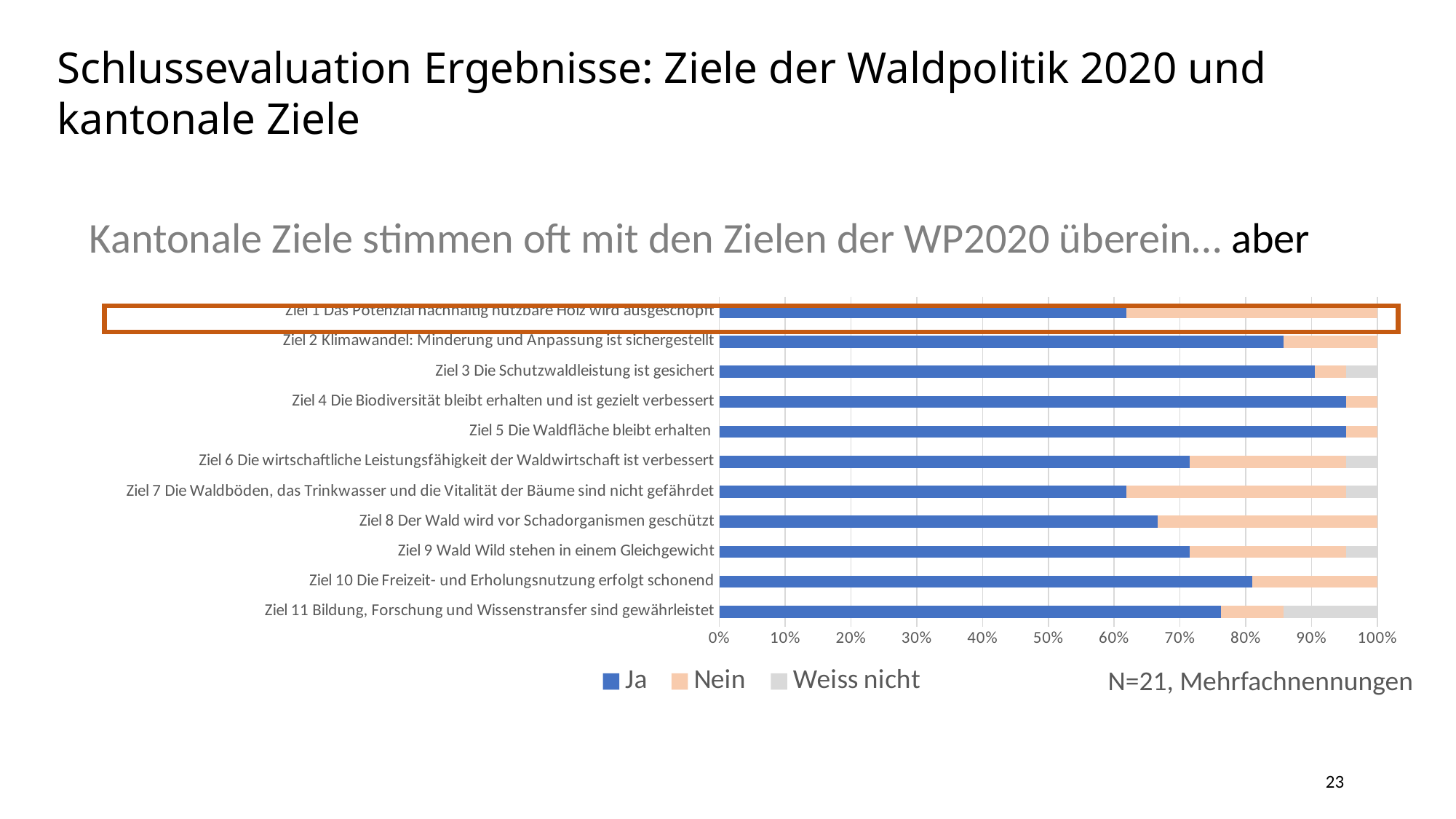
How many goals (Ziele) are listed as categories in the chart? 11 Which goal's bar is highlighted with an orange box on the slide? Ziel 1 Which has a larger 'Ja' share: Ziel 1 or Ziel 2? Ziel 2 What are the three legend entries of the chart? Ja, Nein, Weiss nicht Is the 'Ja' value for Ziel 1 greater or less than 70%? less Is the 'Ja' value for Ziel 2 greater or less than 80%? greater Which goal has the largest 'Weiss nicht' share? Ziel 11 What kind of chart is shown on the slide? Stacked bar chart How many series does the chart legend list? 3 Which has a larger 'Ja' share: Ziel 8 or Ziel 10? Ziel 10 Is the 'Ja' value for Ziel 11 greater or less than 80%? less